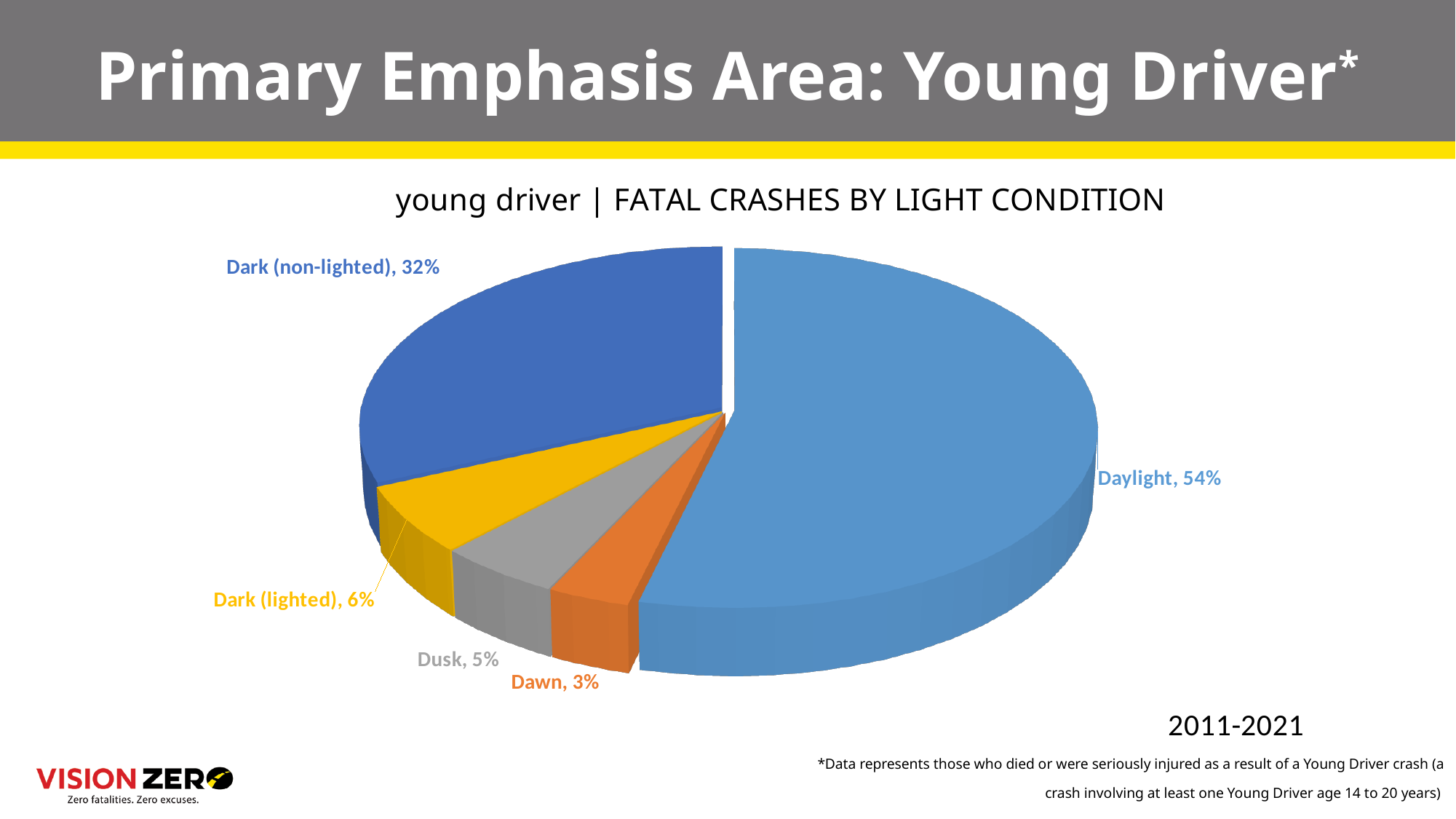
What time period does the chart data cover? 2011-2021 Which has a larger share, Dark (lighted) or Dusk? Dark (lighted) What share of young driver fatal crashes occurred in Daylight? 54% How many light condition categories are shown in the pie chart? 5 What is the title of the chart? young driver | FATAL CRASHES BY LIGHT CONDITION What share of young driver fatal crashes occurred at Dawn? 3% What is the difference in percentage points between the Daylight and Dark (non-lighted) shares? 22 What kind of chart is shown on the slide? Pie chart Which light condition has the largest share of young driver fatal crashes? Daylight What share of young driver fatal crashes occurred at Dusk? 5% What share of young driver fatal crashes occurred in Dark (non-lighted) conditions? 32% Which light condition has the smallest share of young driver fatal crashes? Dawn